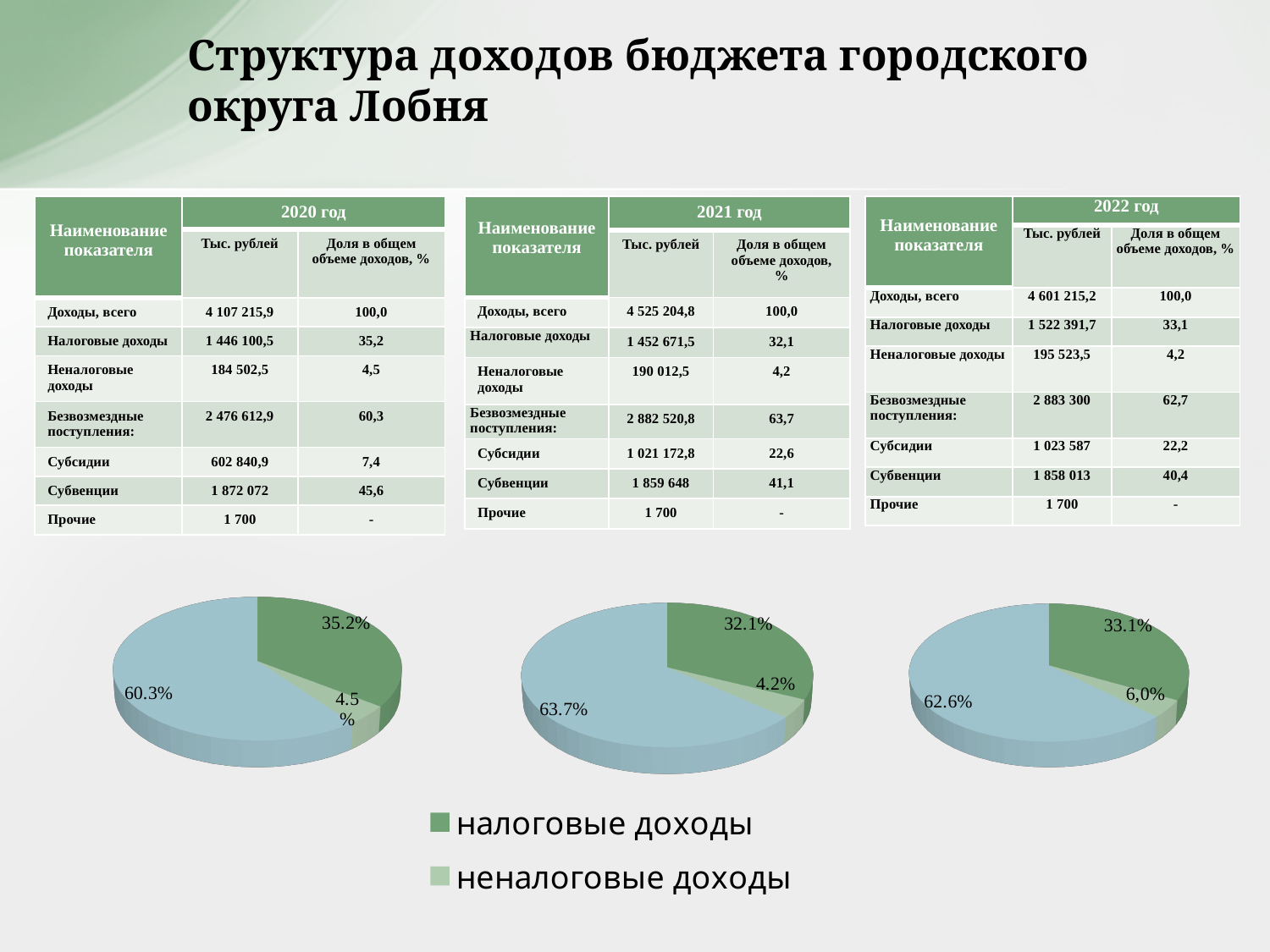
In the left pie chart, what is the share of the largest (blue) slice? 60.3% In the right pie chart, which slice is the smallest? неналоговые доходы In the left pie chart, what share is shown for неналоговые доходы (the light green slice)? 4.5% In the left pie chart, what share is shown for налоговые доходы (the dark green slice)? 35.2% How many entries does the legend below the pie charts list? 2 In the left pie chart, which is larger: the налоговые доходы slice or the неналоговые доходы slice? налоговые доходы In the right pie chart, what share is shown for налоговые доходы? 33.1% In the middle pie chart, what share is shown for налоговые доходы? 32.1% In the middle pie chart, what share is shown for неналоговые доходы? 4.2% In the middle pie chart, what is the share of the largest (blue) slice? 63.7% What kind of chart is shown in the left chart at the bottom of the slide? pie chart In the right pie chart, what share is shown for неналоговые доходы? 6,0%